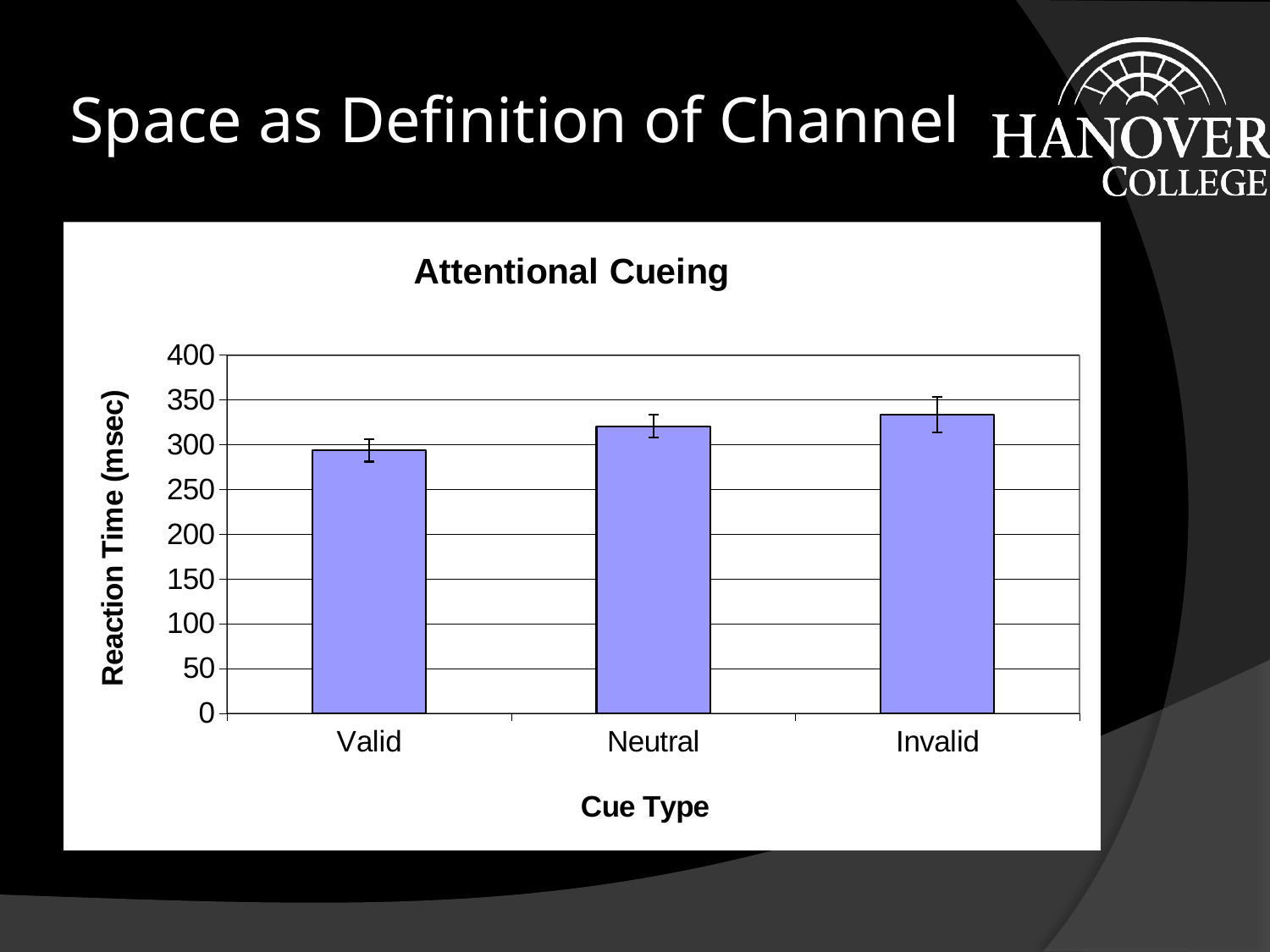
Which cue type has the lowest reaction time? Valid How many cue types are plotted in the Attentional Cueing chart? 3 Is the reaction time for Valid greater or less than 250? greater Which has a larger reaction time, Valid or Invalid? Invalid Is the reaction time for Invalid greater or less than 350? less Which has a larger reaction time, Valid or Neutral? Neutral What kind of chart is shown on the slide? bar chart Do the reaction times rise or fall from Valid to Invalid along the x axis? rise Is the reaction time for Neutral greater or less than 300? greater What is the label of the vertical axis? Reaction Time (msec) Which cue type has the highest reaction time? Invalid What is the title of the chart? Attentional Cueing